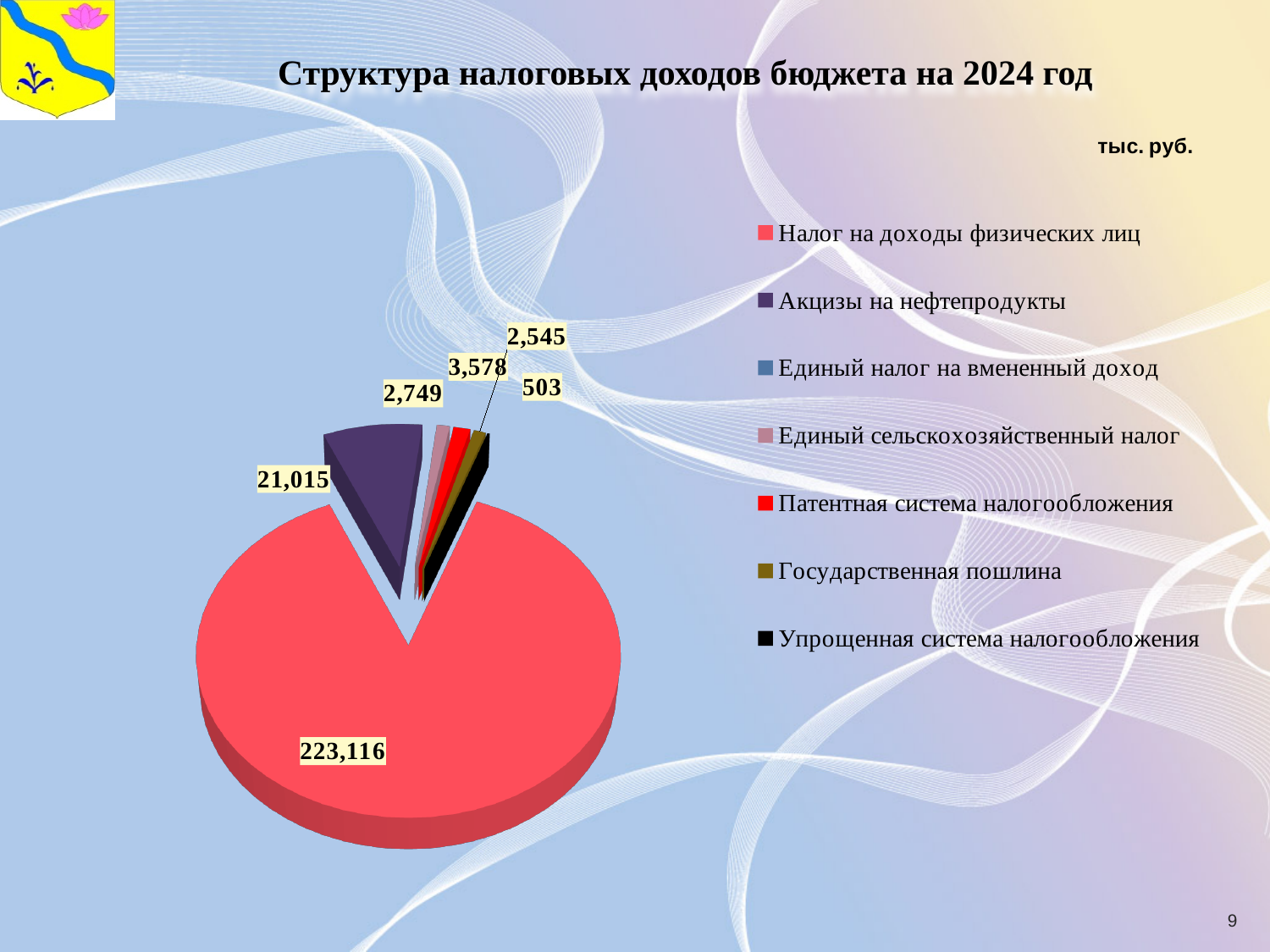
What is the value for Акцизы на нефтепродукты? 21,015 What is the smallest data label printed on the pie chart? 503 Which is larger: Налог на доходы физических лиц or Акцизы на нефтепродукты? Налог на доходы физических лиц In what units are the values on the chart given? тыс. руб. How many categories does the legend list? 7 What is the value for Налог на доходы физических лиц? 223,116 What is the difference between the values for Налог на доходы физических лиц and Акцизы на нефтепродукты? 202,101 Which category has the largest slice of the pie? Налог на доходы физических лиц How many data labels are printed on the pie chart? 6 What type of chart is shown on the slide? Pie chart What is the title of the chart? Структура налоговых доходов бюджета на 2024 год